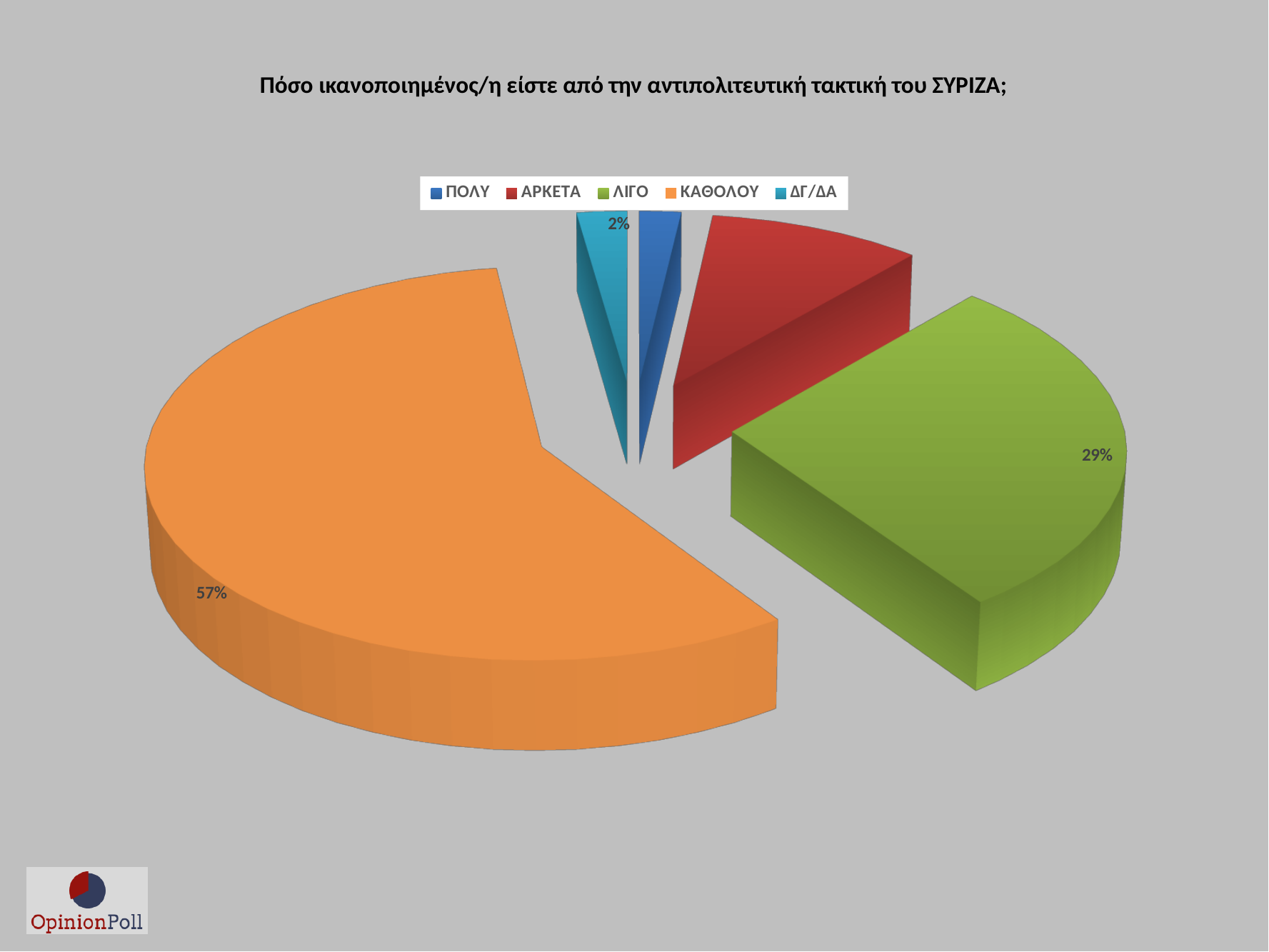
What is the difference in percentage points between ΚΑΘΟΛΟΥ and ΛΙΓΟ? 28 percentage points Which is larger, the slice for ΑΡΚΕΤΑ or the slice for ΛΙΓΟ? ΛΙΓΟ What is the title of the chart? Πόσο ικανοποιημένος/η είστε από την αντιπολιτευτική τακτική του ΣΥΡΙΖΑ; What share of the pie does ΛΙΓΟ represent? 29% What percentage is shown for ΛΙΓΟ? 29% What kind of chart is shown on the slide? pie chart Which is larger, the slice for ΛΙΓΟ or the slice for ΚΑΘΟΛΟΥ? ΚΑΘΟΛΟΥ What percentage is shown for ΚΑΘΟΛΟΥ? 57% Which category has the largest slice of the pie chart? ΚΑΘΟΛΟΥ Does the ΚΑΘΟΛΟΥ slice account for more or less than half of the pie? more What colour is the ΚΑΘΟΛΟΥ slice in the pie chart? orange How many categories does the legend of the pie chart list? 5